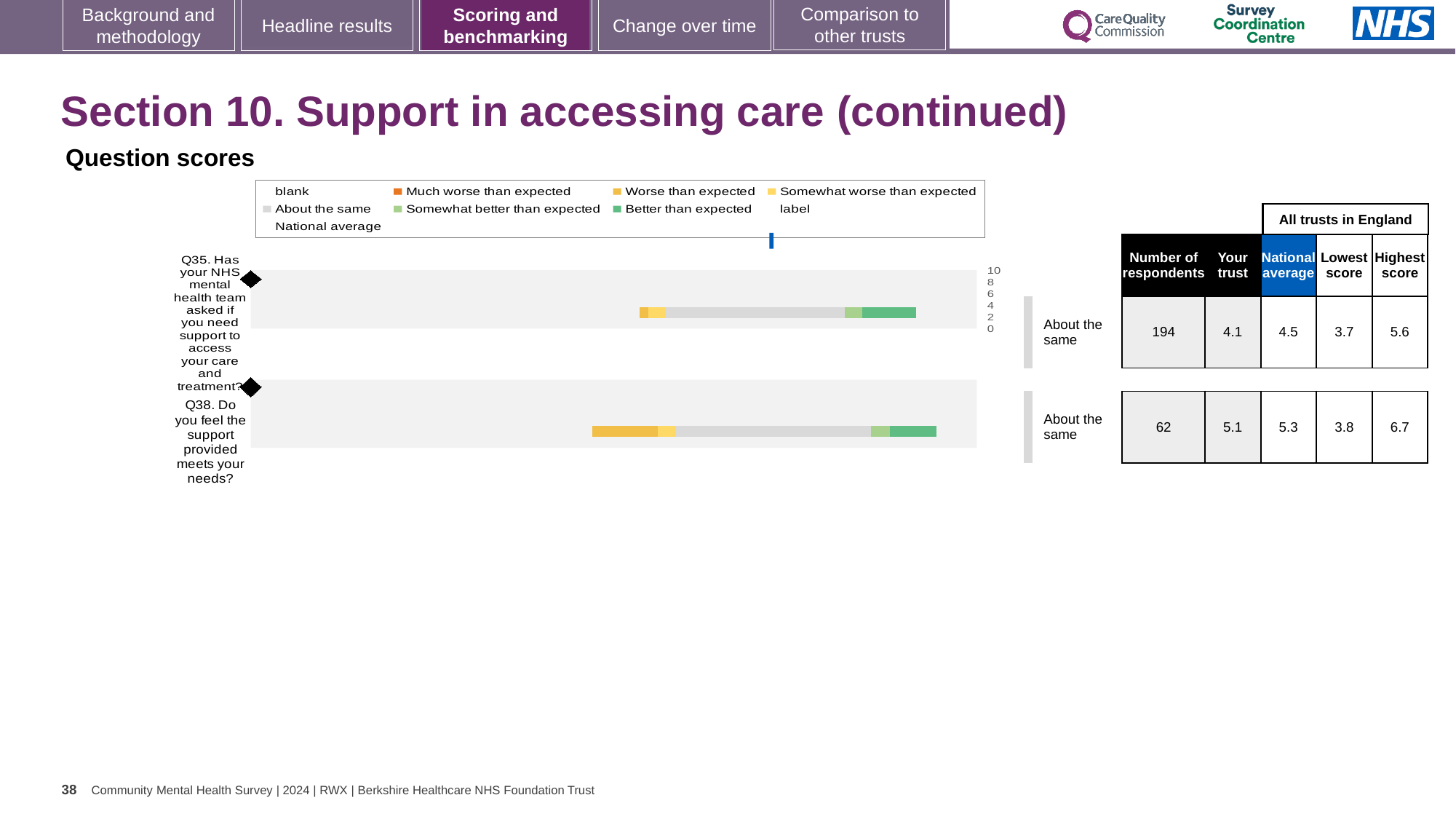
What benchmark category is shown next to the bar for Q38? About the same What is the 'Your trust' score for Q38 (Do you feel the support provided meets your needs?)? 5.1 How many respondents answered Q35? 194 What is the difference between the highest score and the lowest score for Q38? 2.9 What is the lowest score across all trusts in England for Q35? 3.7 What is the 'Your trust' score for Q35 (Has your NHS mental health team asked if you need support to access your care and treatment?)? 4.1 Which question has the higher 'Your trust' score, Q35 or Q38? Q38 How many questions are plotted in the question scores chart? 2 What kind of chart is used to show the question scores for Q35 and Q38? Bar chart Which question has the higher 'Highest score' across all trusts in England? Q38 What is the national average score for Q38? 5.3 How much higher is the national average than the 'Your trust' score for Q35? 0.4